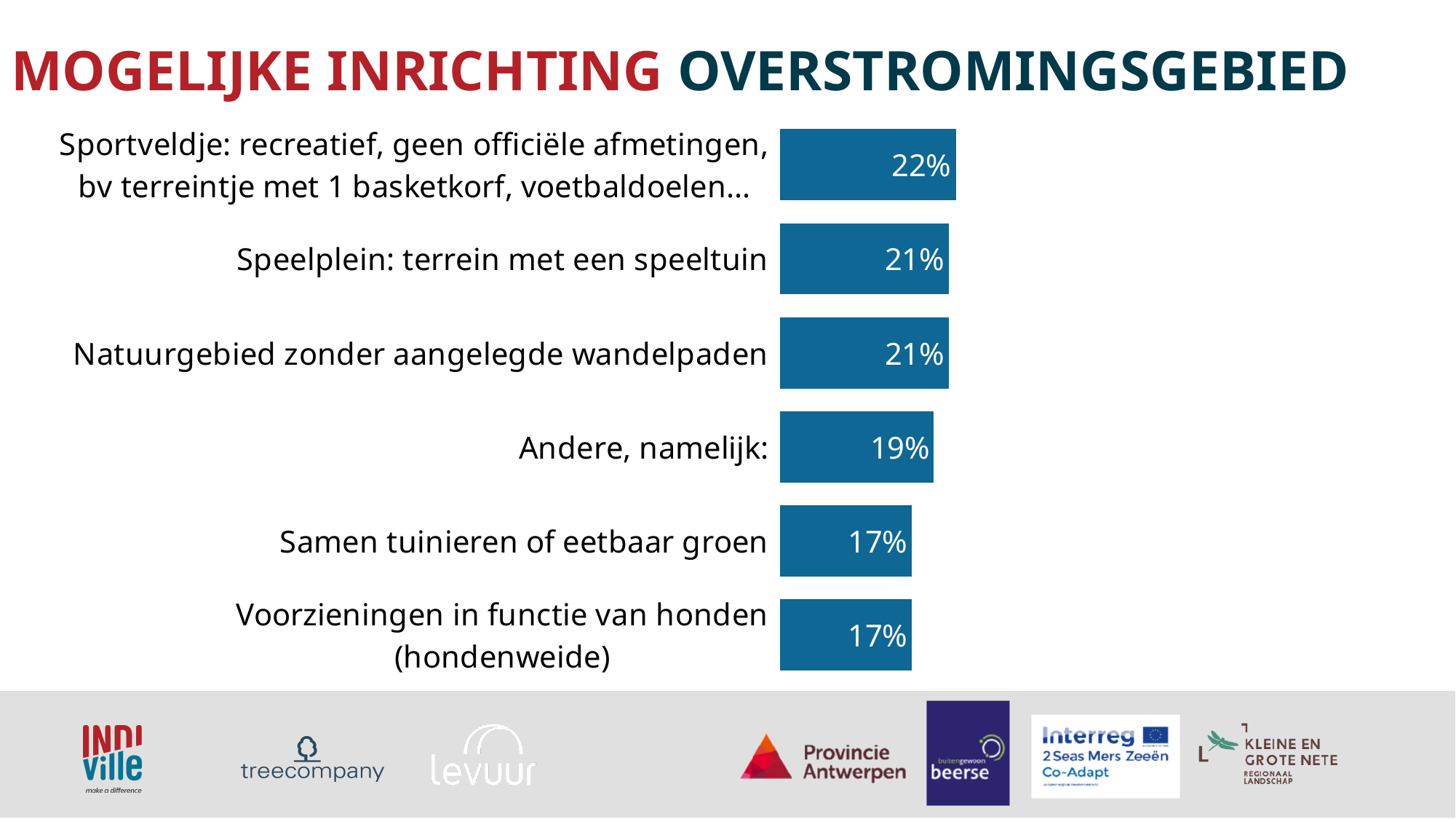
What kind of chart is shown on the slide? Bar chart Which category has the highest value in the chart? Sportveldje: recreatief, geen officiële afmetingen, bv terreintje met 1 basketkorf, voetbaldoelen… What is the title of the slide containing the chart? MOGELIJKE INRICHTING OVERSTROMINGSGEBIED What percentage is shown for "Samen tuinieren of eetbaar groen"? 17% Which is larger: the value for "Andere, namelijk:" or the value for "Samen tuinieren of eetbaar groen"? Andere, namelijk: What percentage is shown for "Natuurgebied zonder aangelegde wandelpaden"? 21% What is the difference between the value for "Speelplein: terrein met een speeltuin" and the value for "Samen tuinieren of eetbaar groen"? 4% What percentage is shown for "Speelplein: terrein met een speeltuin"? 21% What is the difference between the value for "Sportveldje" and the value for "Andere, namelijk:"? 3% What value is shown for "Voorzieningen in functie van honden (hondenweide)"? 17% How many categories are shown in the chart? 6 What value is shown for "Andere, namelijk:"? 19%